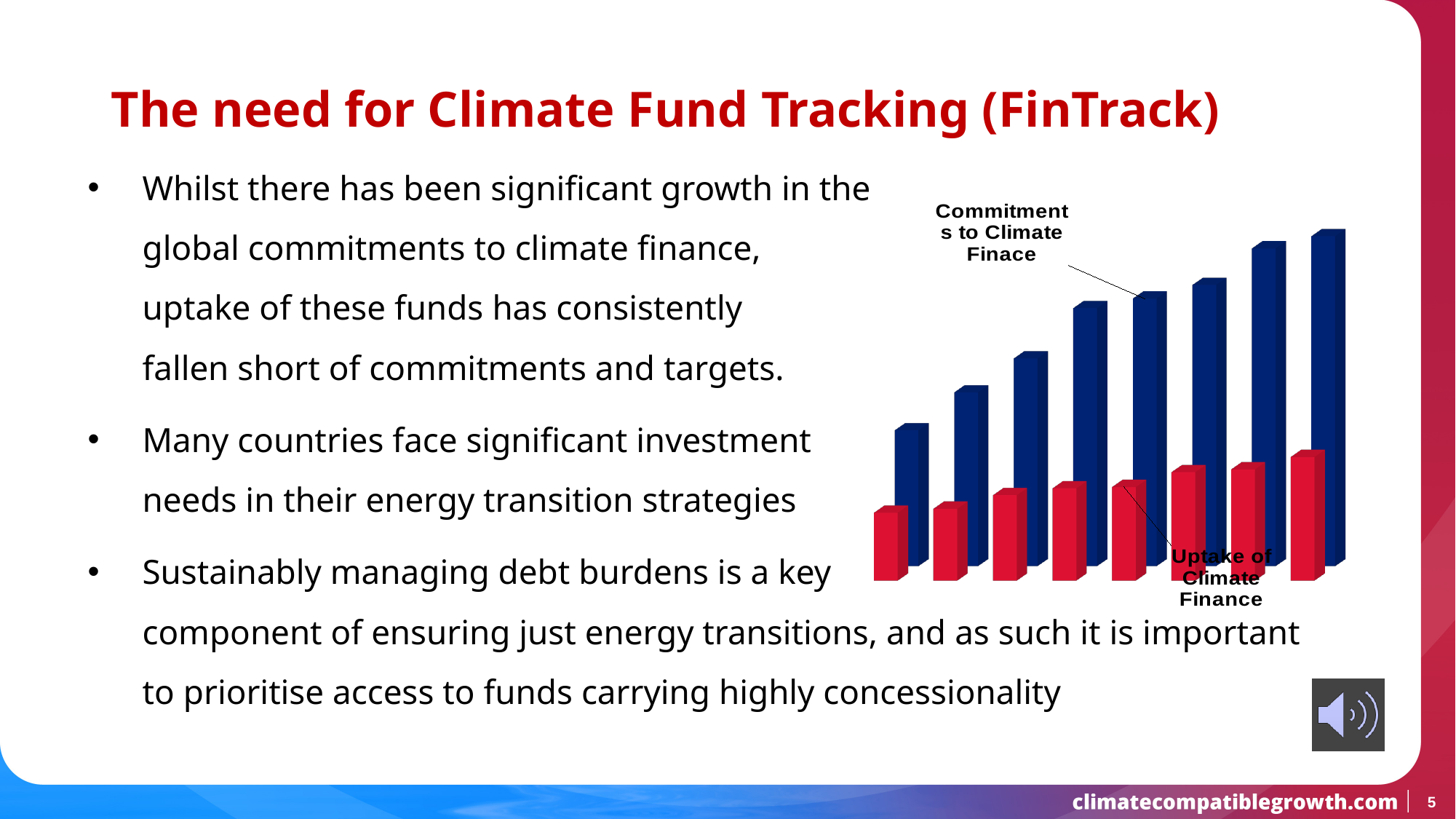
Do the Commitments to Climate Finance bars rise or fall from left to right? Rise In each group, which series has the taller bar: Commitments to Climate Finance or Uptake of Climate Finance? Commitments to Climate Finance What kind of chart is shown on the slide? Bar chart Is the tallest Commitments to Climate Finance bar on the left or the right side of the chart? Right How many groups of bars (categories) does the chart show? 8 What colour are the Commitments to Climate Finance bars? Blue Is the shortest Uptake of Climate Finance bar on the left or the right side of the chart? Left How many data series are labelled on the chart? 2 What colour are the Uptake of Climate Finance bars? Red Do the Uptake of Climate Finance bars rise or fall from left to right? Rise